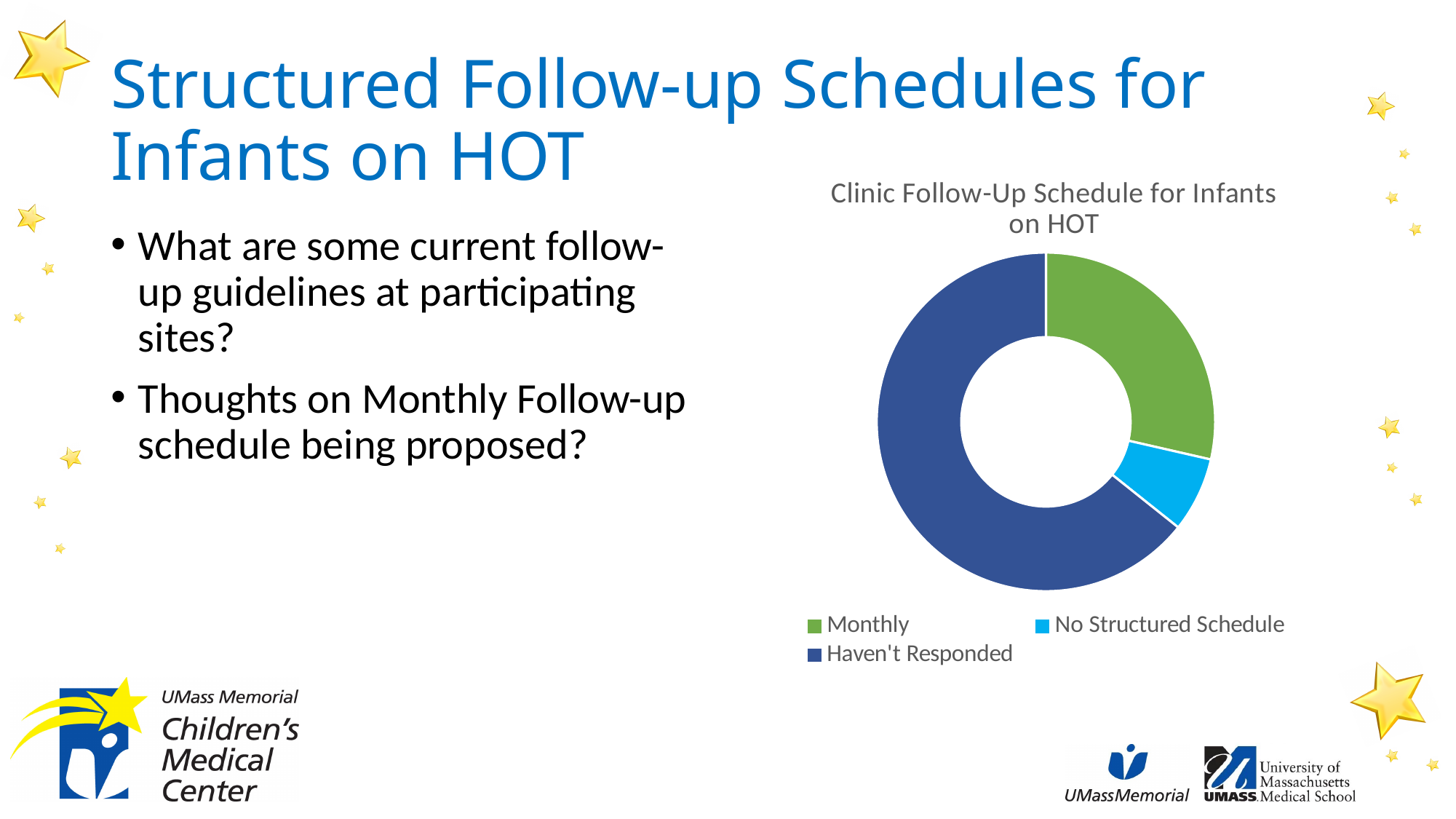
What is the title of the chart? Clinic Follow-Up Schedule for Infants on HOT Does the Haven't Responded slice take up more or less than half of the doughnut chart? More What kind of chart is shown on the slide? Doughnut chart Which is larger in the chart: the Haven't Responded slice or the Monthly slice? Haven't Responded How many categories does the chart's legend list? 3 What colour represents the Monthly category in the chart? Green Which category takes up the smallest share of the doughnut chart? No Structured Schedule Which is larger in the chart: the Monthly slice or the No Structured Schedule slice? Monthly Which category takes up the largest share of the doughnut chart? Haven't Responded